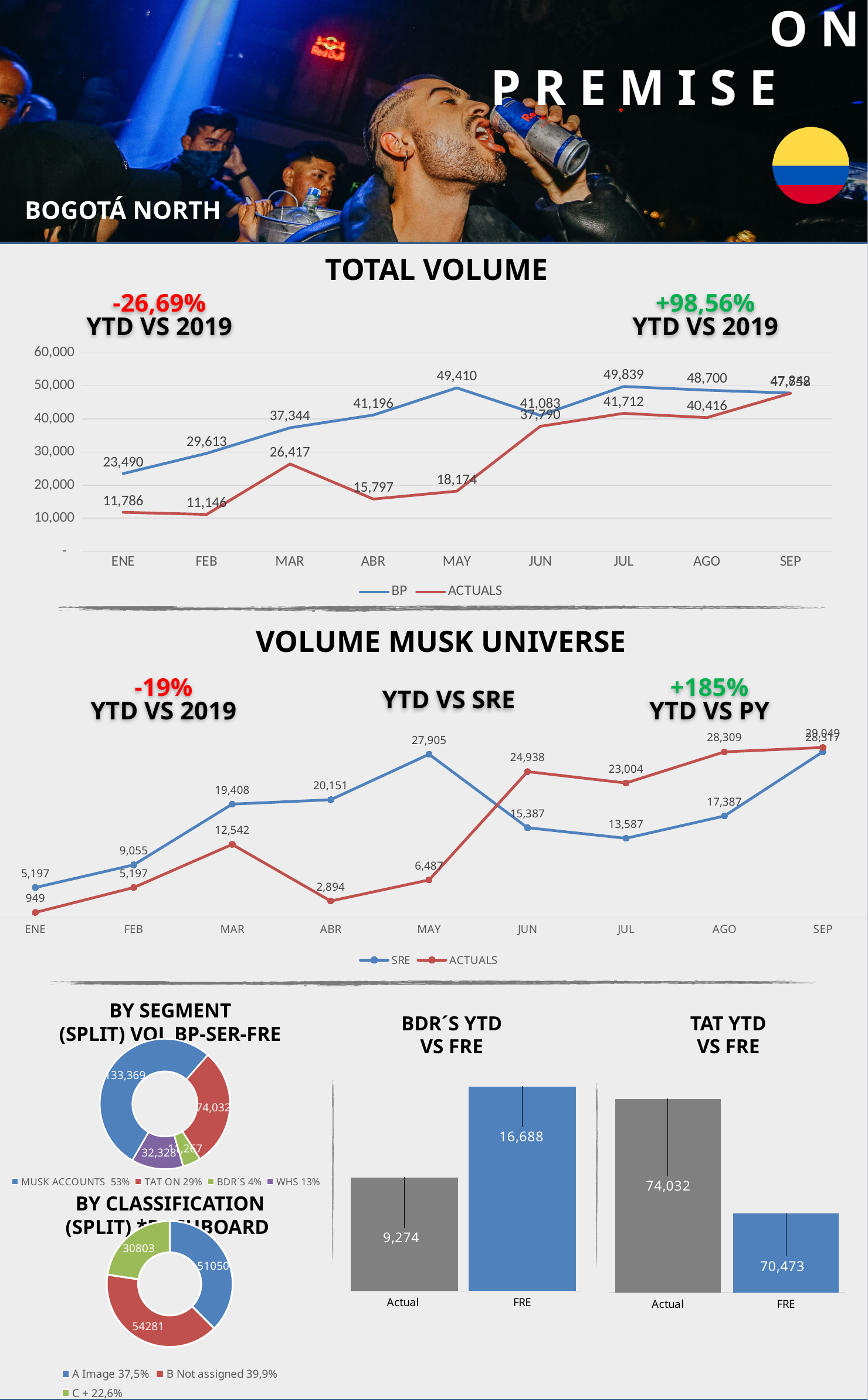
In the TAT YTD VS FRE chart, what is the difference between Actual and FRE? 3,559 In the TOTAL VOLUME chart, what is the difference between the BP and ACTUALS values for ENE? 11,704 In the VOLUME MUSK UNIVERSE chart, what is the SRE value for MAY? 27,905 In the TOTAL VOLUME chart, what is the ACTUALS value for JUN? 37,790 In the TOTAL VOLUME chart, how many series does the legend list? 2 In the TOTAL VOLUME chart, what is the BP value for MAY? 49,410 In the BDR'S YTD VS FRE chart, what is the value for FRE? 16,688 In the VOLUME MUSK UNIVERSE chart, which is larger for JUN, the SRE value or the ACTUALS value? ACTUALS In the VOLUME MUSK UNIVERSE chart, which month has the lowest ACTUALS value? ENE In the BY SEGMENT (SPLIT) donut chart, what share does MUSK ACCOUNTS have? 53% In the BY CLASSIFICATION (SPLIT) donut chart, what is the value for B Not assigned? 54281 In the VOLUME MUSK UNIVERSE chart, how many months are shown on the x axis? 9